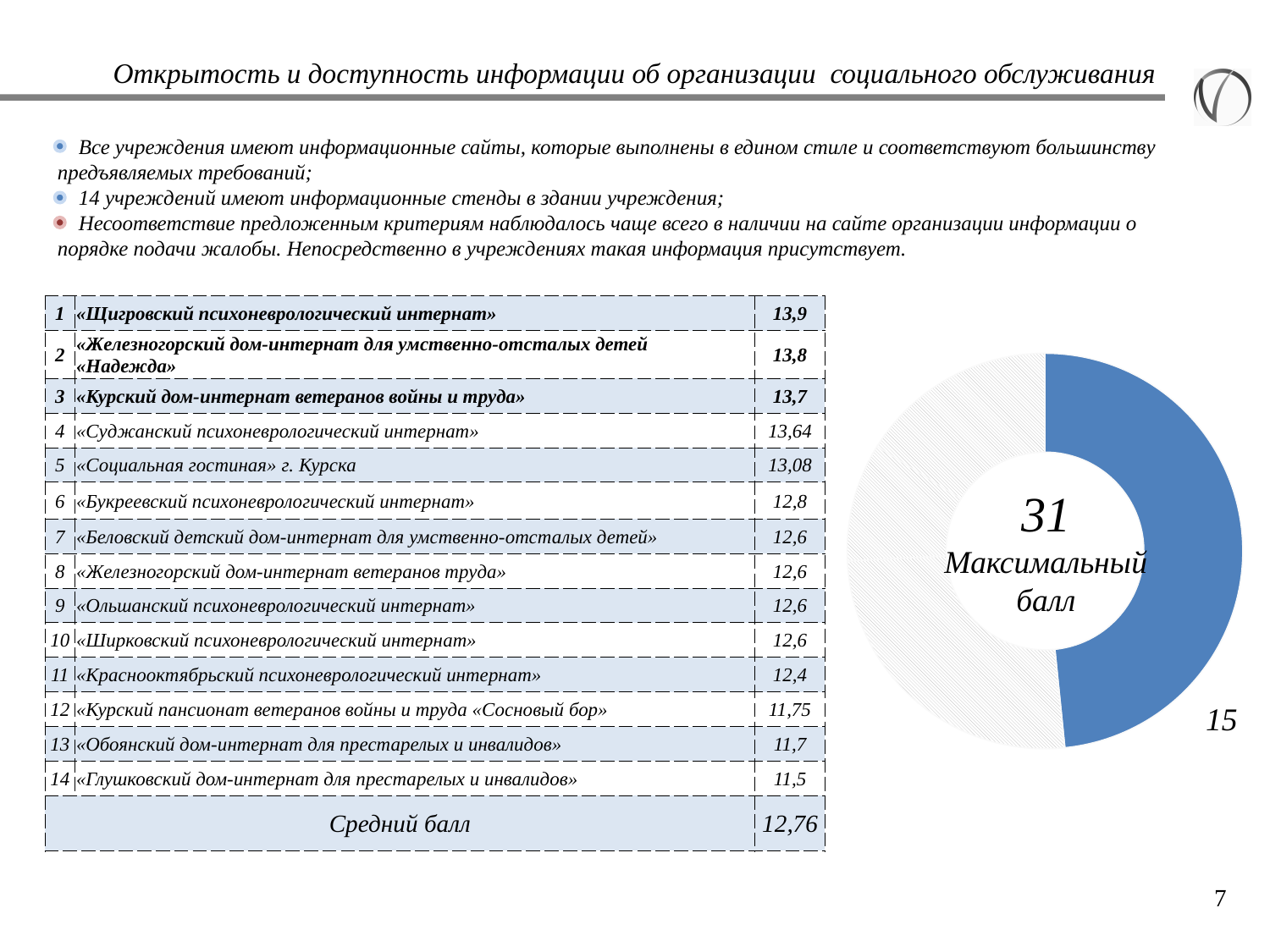
What text accompanies the number in the centre of the doughnut chart? Максимальный балл What kind of chart is shown on the right side of the slide? Doughnut (pie) chart What value is printed as the data label on the blue segment of the doughnut chart? 15 What number is written in the centre of the doughnut chart? 31 Is the value labelled on the blue segment of the doughnut chart greater or less than 20? less